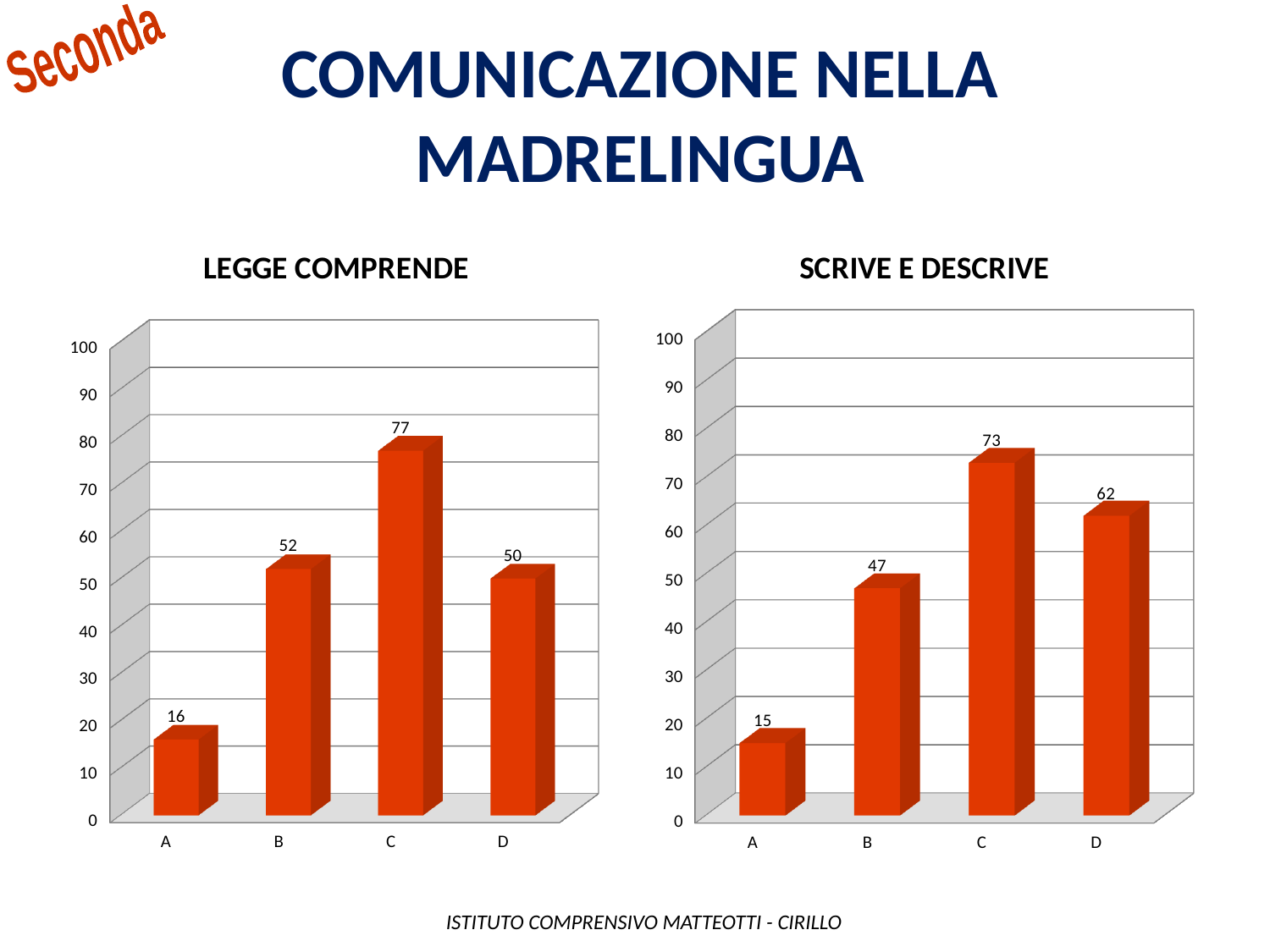
What kind of chart is the SCRIVE E DESCRIVE chart? bar chart What is the title of the chart on the right side of the slide? SCRIVE E DESCRIVE In the LEGGE COMPRENDE chart, what is the value for category C? 77 In the SCRIVE E DESCRIVE chart, is the value for D greater or less than 50? greater In the SCRIVE E DESCRIVE chart, what is the difference between the values for D and A? 47 In the SCRIVE E DESCRIVE chart, which category has the highest value? C How many categories are shown in the LEGGE COMPRENDE chart? 4 In the LEGGE COMPRENDE chart, what is the value for category A? 16 In the SCRIVE E DESCRIVE chart, what is the value for category B? 47 In the LEGGE COMPRENDE chart, which is larger, the value for B or the value for D? B In the LEGGE COMPRENDE chart, what is the difference between the values for C and D? 27 In the LEGGE COMPRENDE chart, which category has the lowest value? A